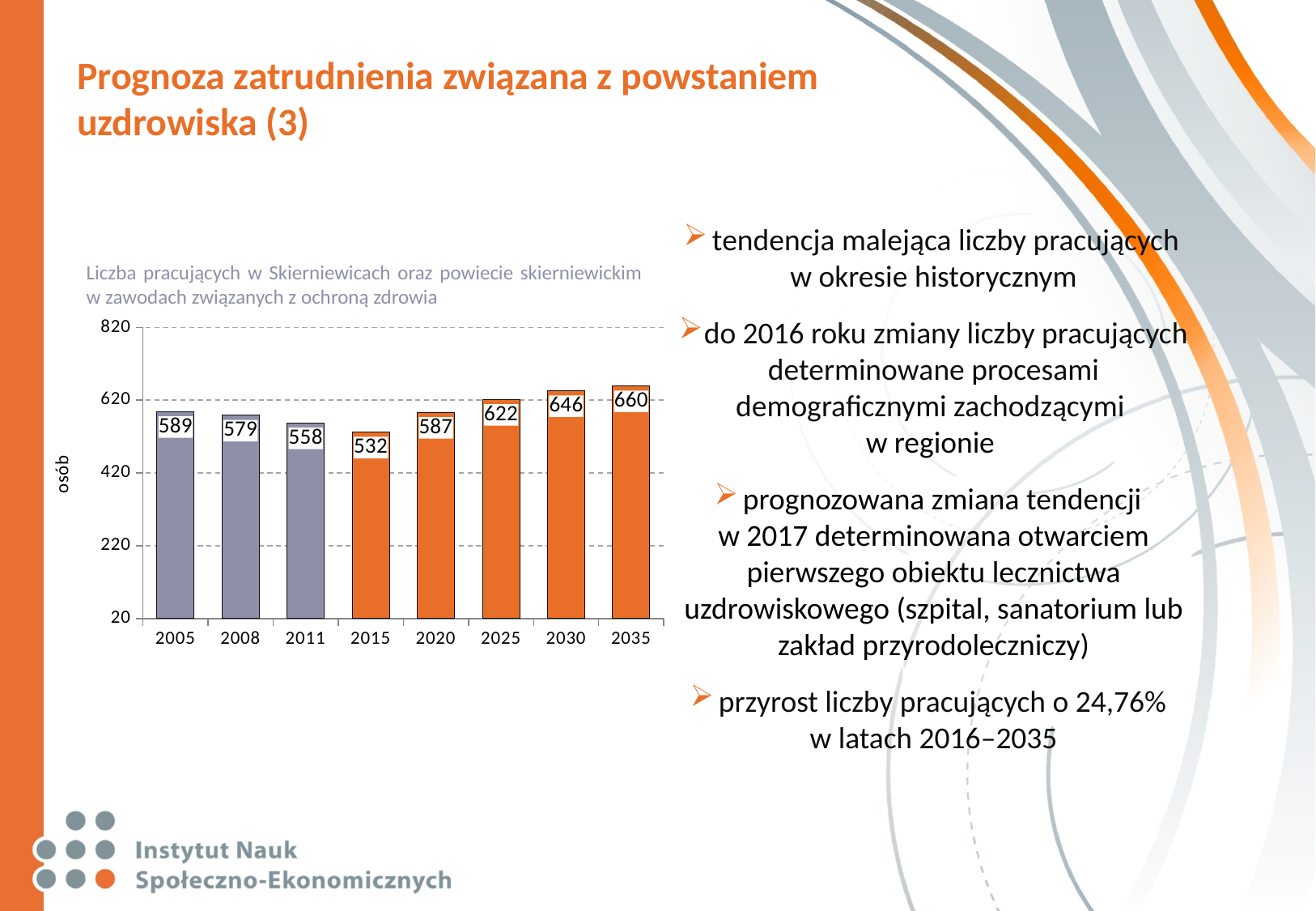
Which is larger, the value for 2008 or the value for 2025? 2025 Which year has the highest value? 2035 How many years are shown on the x axis? 8 What is the label on the vertical axis? osób Do the values rise or fall from 2015 to 2035? rise What is the difference between the values for 2035 and 2015? 128 What is the value for 2035? 660 What kind of chart is shown? bar chart What is the value for 2015? 532 What is the value for 2005? 589 Is the value for 2030 greater or less than 620? greater Which year has the lowest value? 2015